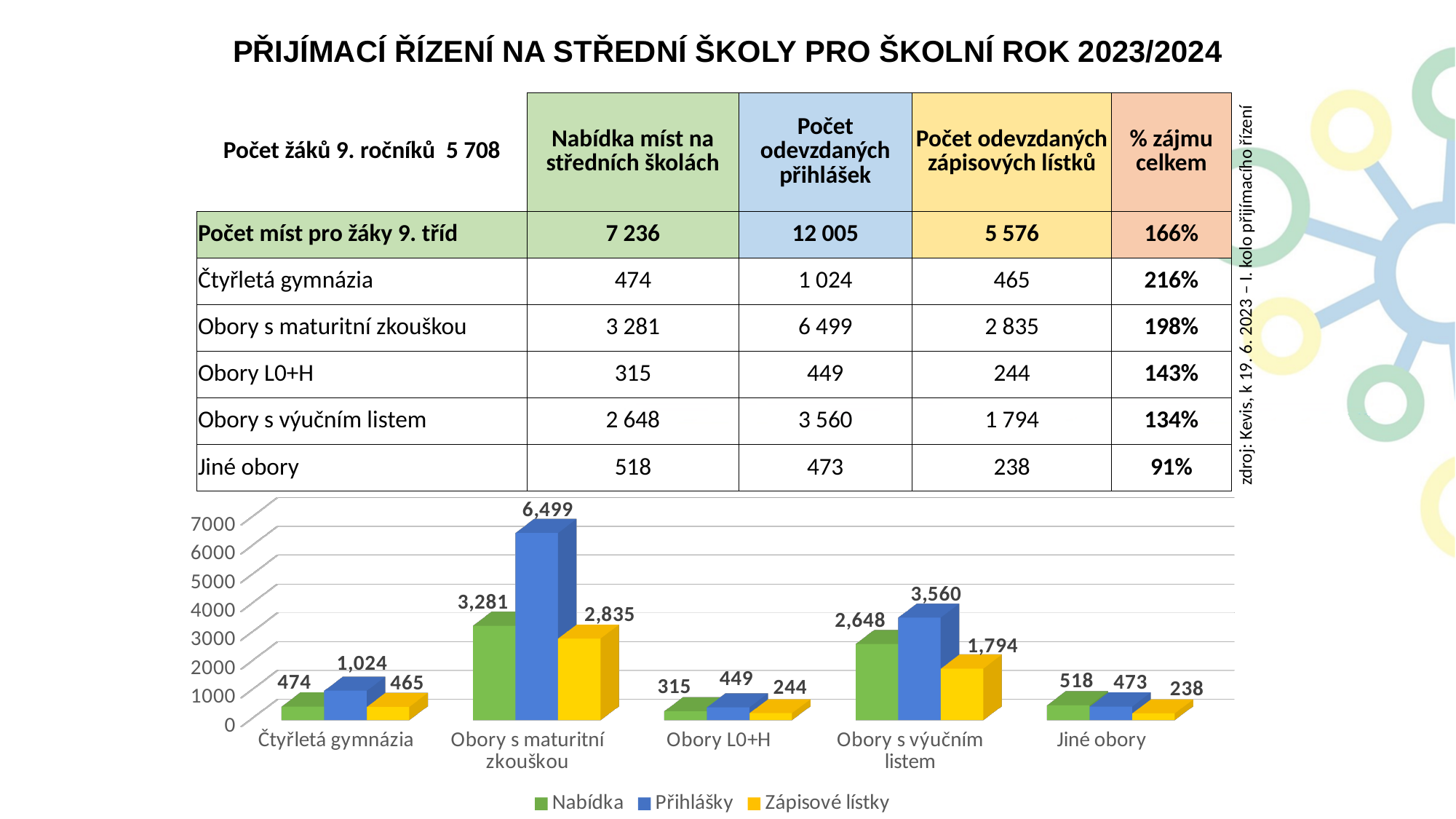
How many categories are shown on the x axis of the chart? 5 Which is larger for Jiné obory in the chart: Nabídka or Přihlášky? Nabídka What is the difference between Přihlášky and Nabídka for Obory s výučním listem in the chart? 912 What is the value of Zápisové lístky for Čtyřletá gymnázia in the chart? 465 Which category has the highest Přihlášky value in the chart? Obory s maturitní zkouškou How many series does the chart legend list? 3 What is the value of Přihlášky for Obory s maturitní zkouškou in the chart? 6,499 Which category has the lowest Zápisové lístky value in the chart? Jiné obory Is the Přihlášky value for Obory s maturitní zkouškou greater or less than 6000? greater What type of chart is shown on the slide? bar chart What is the value of Nabídka for Obory s výučním listem in the chart? 2,648 Which colour represents the Zápisové lístky series in the chart? yellow